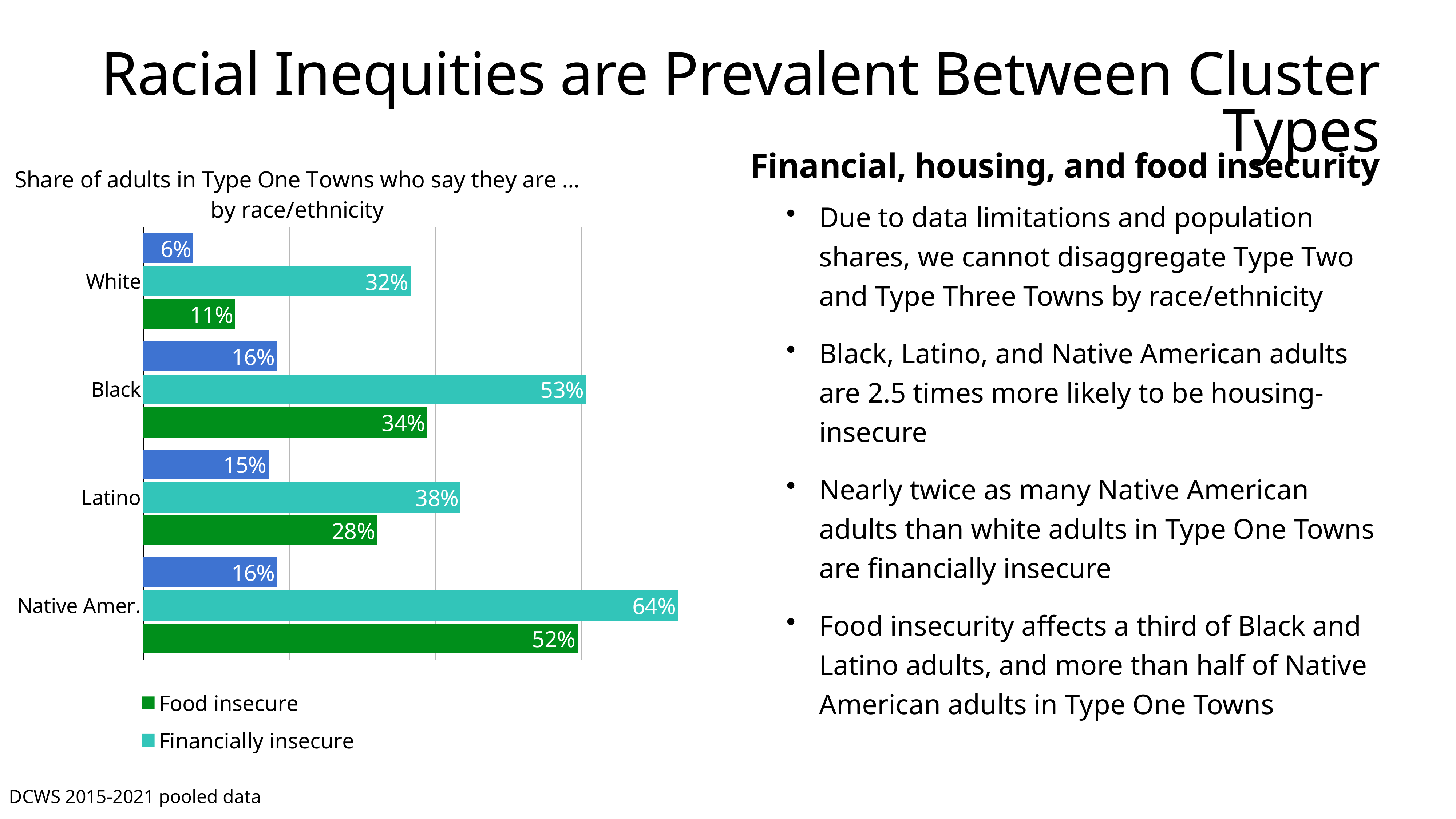
What is the Financially insecure value for Native Amer.? 64% Which race/ethnicity has the lowest Food insecure value? White How many series does the chart's legend list? 2 What is the Financially insecure value for White adults? 32% What is the difference between the Financially insecure and Food insecure values for Black adults? 19% Which is larger, the Food insecure value for Black adults or for Latino adults? Black What kind of chart is shown on the slide? Bar chart What is the Food insecure value for Latino adults? 28% Which race/ethnicity has the highest Financially insecure value? Native Amer. How many race/ethnicity categories are shown on the chart? 4 What is the difference between the Financially insecure values for Native Amer. and White adults? 32% What is the Food insecure value for Black adults? 34%